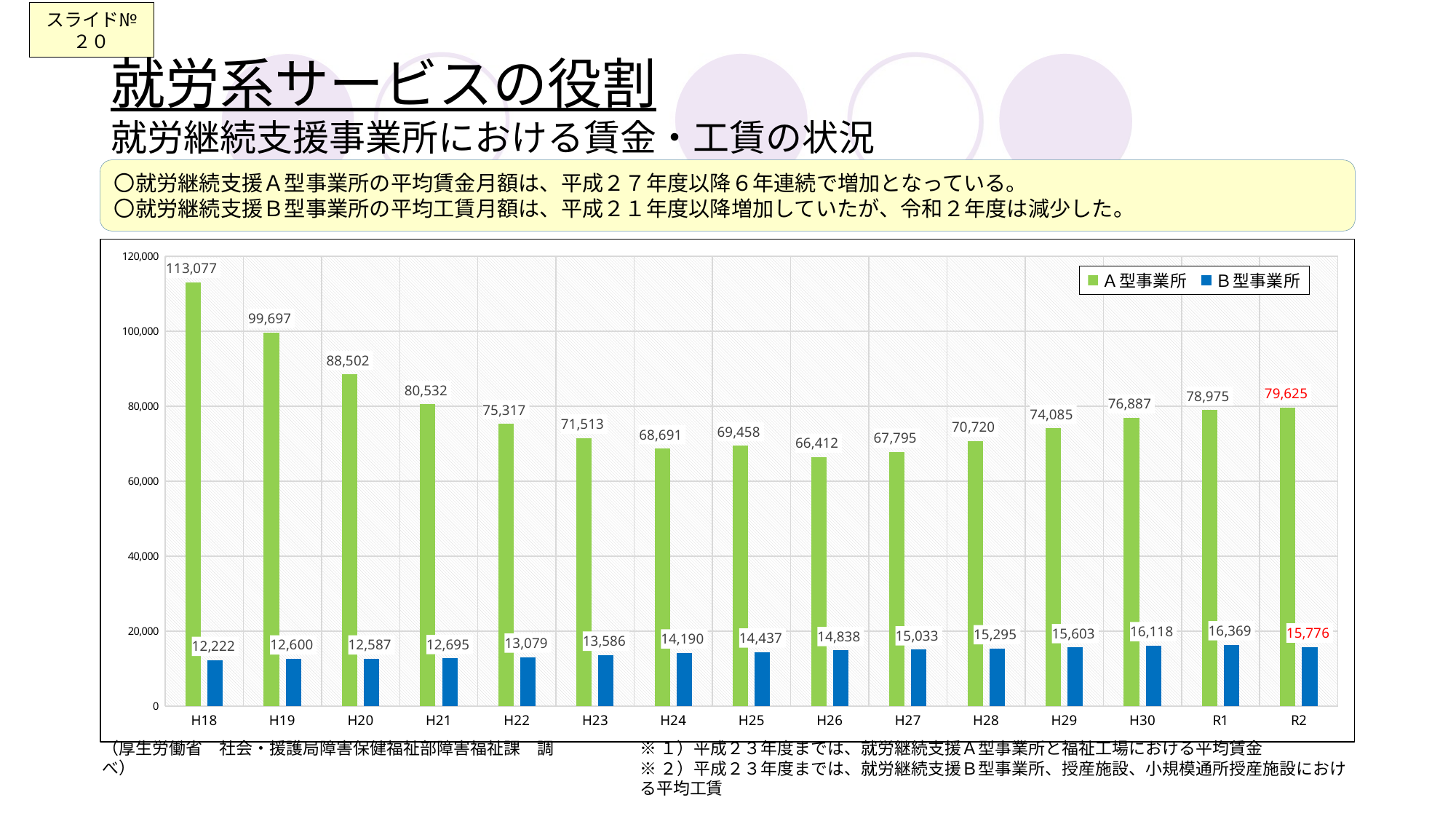
How many series does the legend list? 2 In which year is the B型事業所 value lowest? H18 Is the A型事業所 value for H22 greater or less than 80,000? less In which year is the B型事業所 value highest? R1 What is the value for A型事業所 in H18? 113,077 How many years are shown on the x axis? 15 In which year is the A型事業所 value highest? H18 In which year is the A型事業所 value lowest? H26 What is the difference between the A型事業所 values for R2 and R1? 650 What kind of chart is shown on the slide? bar chart Which is larger, the B型事業所 value for H30 or for R2? H30 What is the value for B型事業所 in R2? 15,776